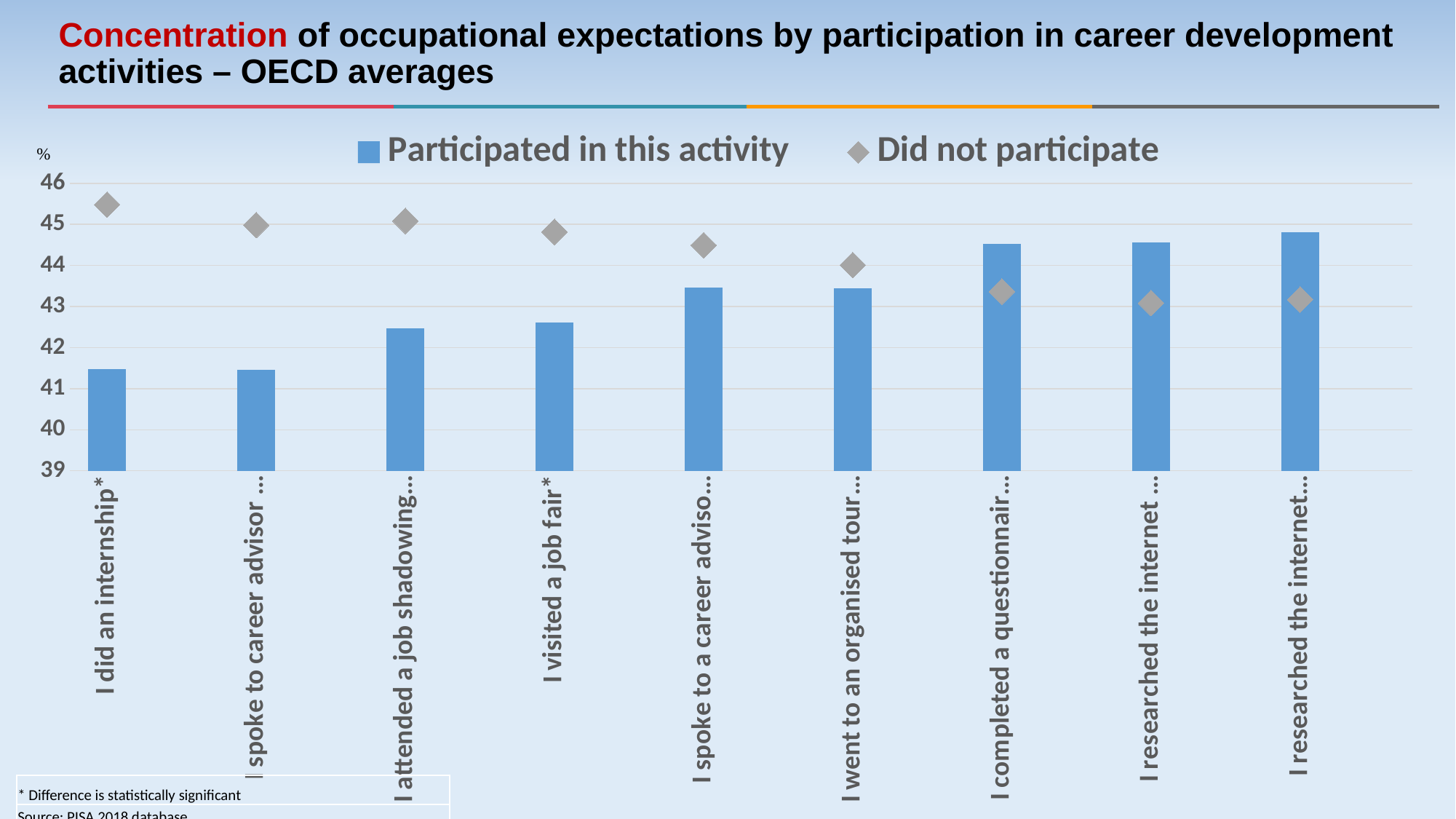
Is the 'Did not participate' value for 'I did an internship*' greater or less than 45? greater Is the 'Did not participate' value for 'I visited a job fair*' greater or less than 45? less Is the 'Participated in this activity' value for 'I did an internship*' greater or less than 42? less What kind of chart is shown on the slide? bar chart How many series does the legend list? 2 Do the 'Participated in this activity' bars generally rise or fall from left to right across the chart? rise For 'I visited a job fair*', which is larger: the 'Participated in this activity' value or the 'Did not participate' value? Did not participate Which activity has the highest 'Did not participate' value? I did an internship* Which series is shown with grey diamond markers? Did not participate Which has the larger 'Participated in this activity' value: 'I did an internship*' or 'I visited a job fair*'? I visited a job fair* How many career development activities (categories) are plotted on the chart? 9